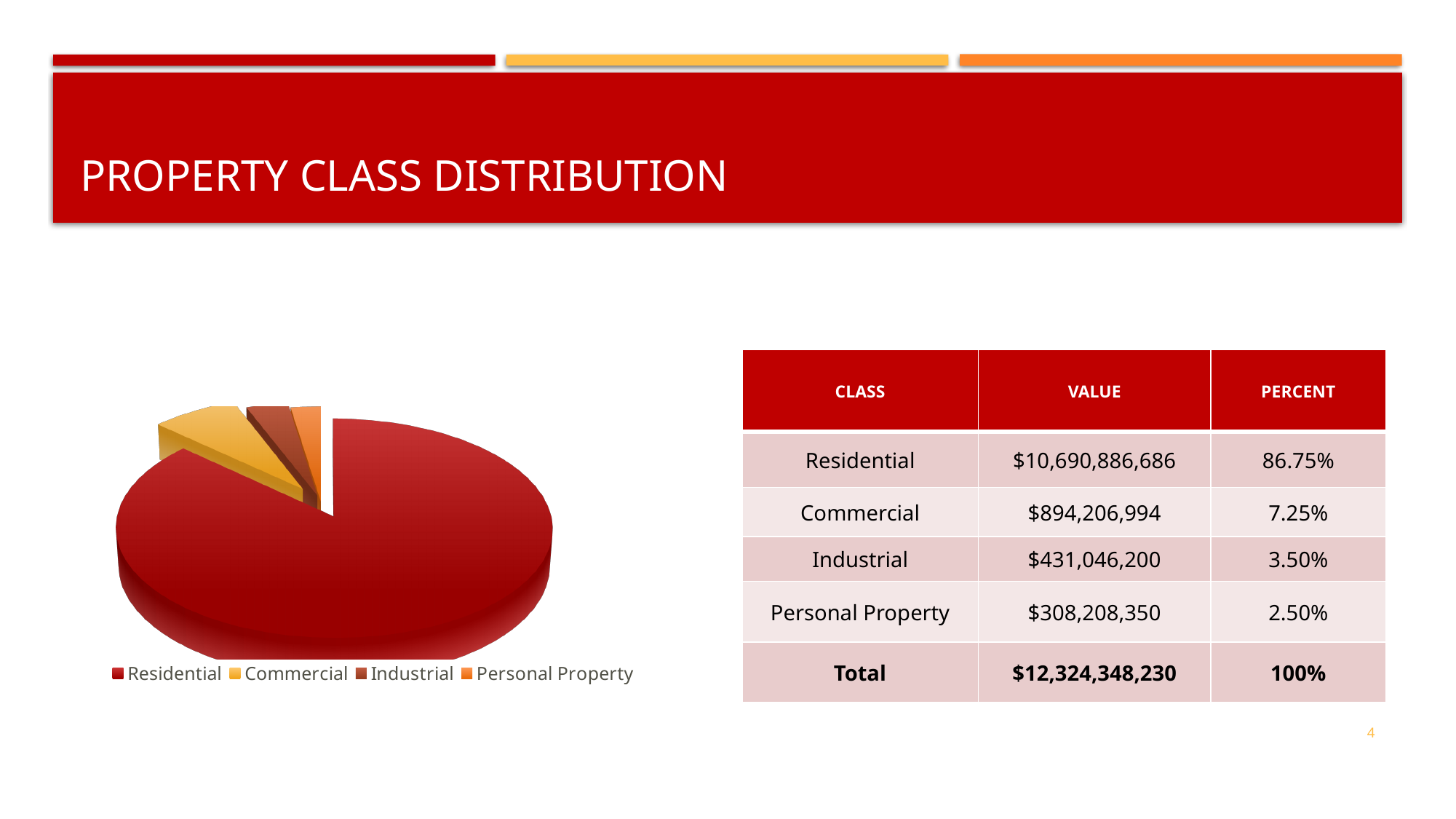
What is the value shown for Personal Property on the slide? $308,208,350 What is the value shown for Commercial on the slide? $894,206,994 What kind of chart is shown on the slide? Pie chart Which slice is larger in the pie chart, Commercial or Industrial? Commercial Which property class has the smallest slice of the pie chart? Personal Property According to the slide, what share of the total does the Commercial slice represent? 7.25% According to the slide, what share of the total does the Industrial slice represent? 3.50% Which property class has the largest slice of the pie chart? Residential What colour is the Residential slice in the pie chart? Red What is the total value of all property classes shown on the slide? $12,324,348,230 How many categories does the pie chart's legend list? 4 According to the slide, what share of the total does the Residential slice represent? 86.75%